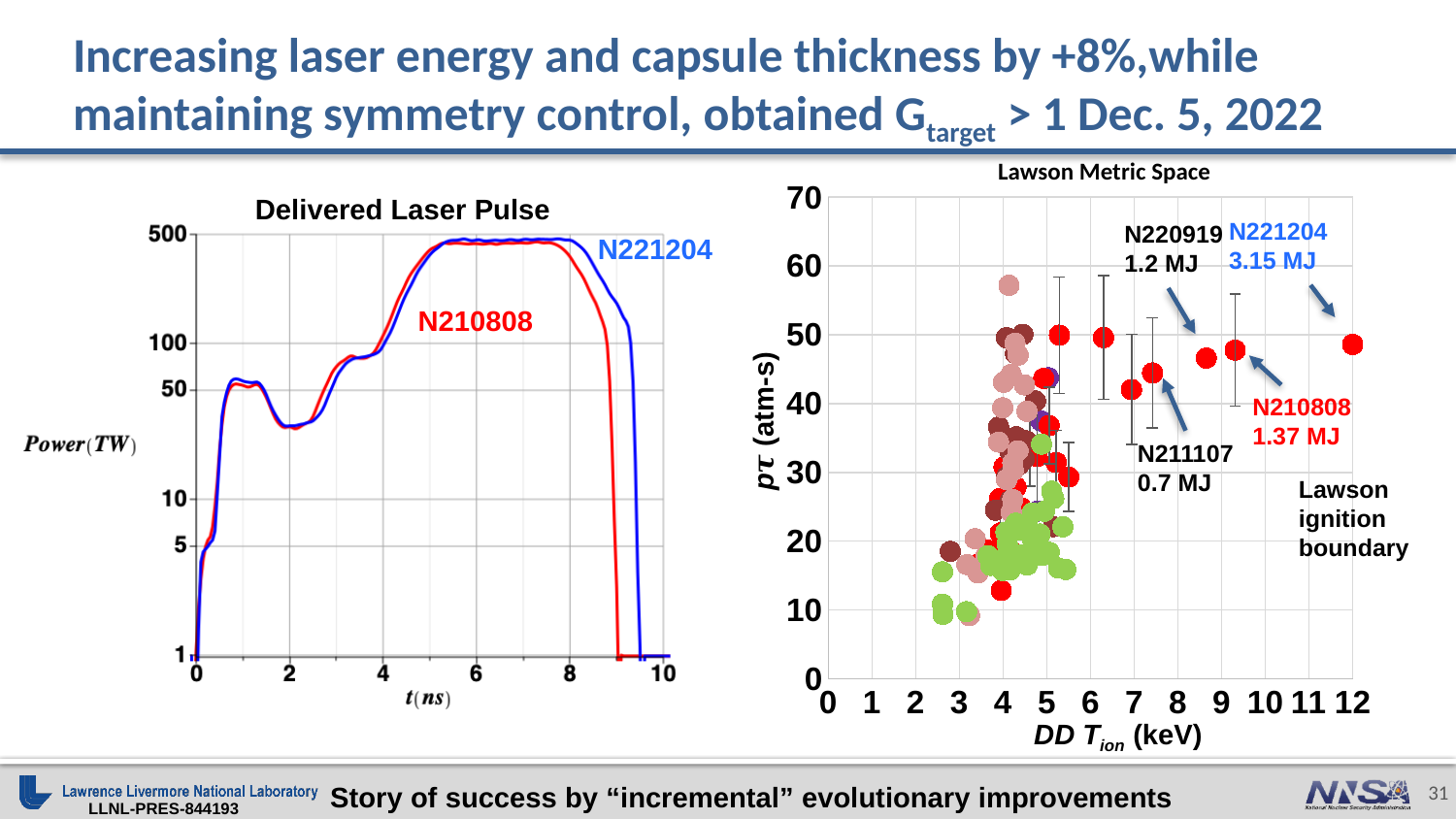
In the Delivered Laser Pulse chart, which shot's pulse extends to a later time before dropping to 1 TW, N221204 or N210808? N221204 In the Delivered Laser Pulse chart, is the power at t = 2 ns greater or less than 50 TW? less In the Delivered Laser Pulse chart, what is the label of the y axis? Power (TW) In the Lawson Metric Space chart, is the DD T_ion value for shot N221204 greater or less than 10 keV? greater In the Lawson Metric Space chart, which of the labeled shots has the highest laser energy? N221204 In the Delivered Laser Pulse chart, is the peak power of the N221204 pulse greater or less than 100 TW? greater What kind of chart is the Lawson Metric Space chart? scatter plot In the Delivered Laser Pulse chart, how many laser pulses (shots) are plotted? 2 In the Lawson Metric Space chart, what is the difference in laser energy between N221204 (3.15 MJ) and N210808 (1.37 MJ)? 1.78 MJ What kind of chart is the Delivered Laser Pulse chart? line chart In the Lawson Metric Space chart, what laser energy is given for shot N221204? 3.15 MJ In the Lawson Metric Space chart, what laser energy is given for shot N211107? 0.7 MJ